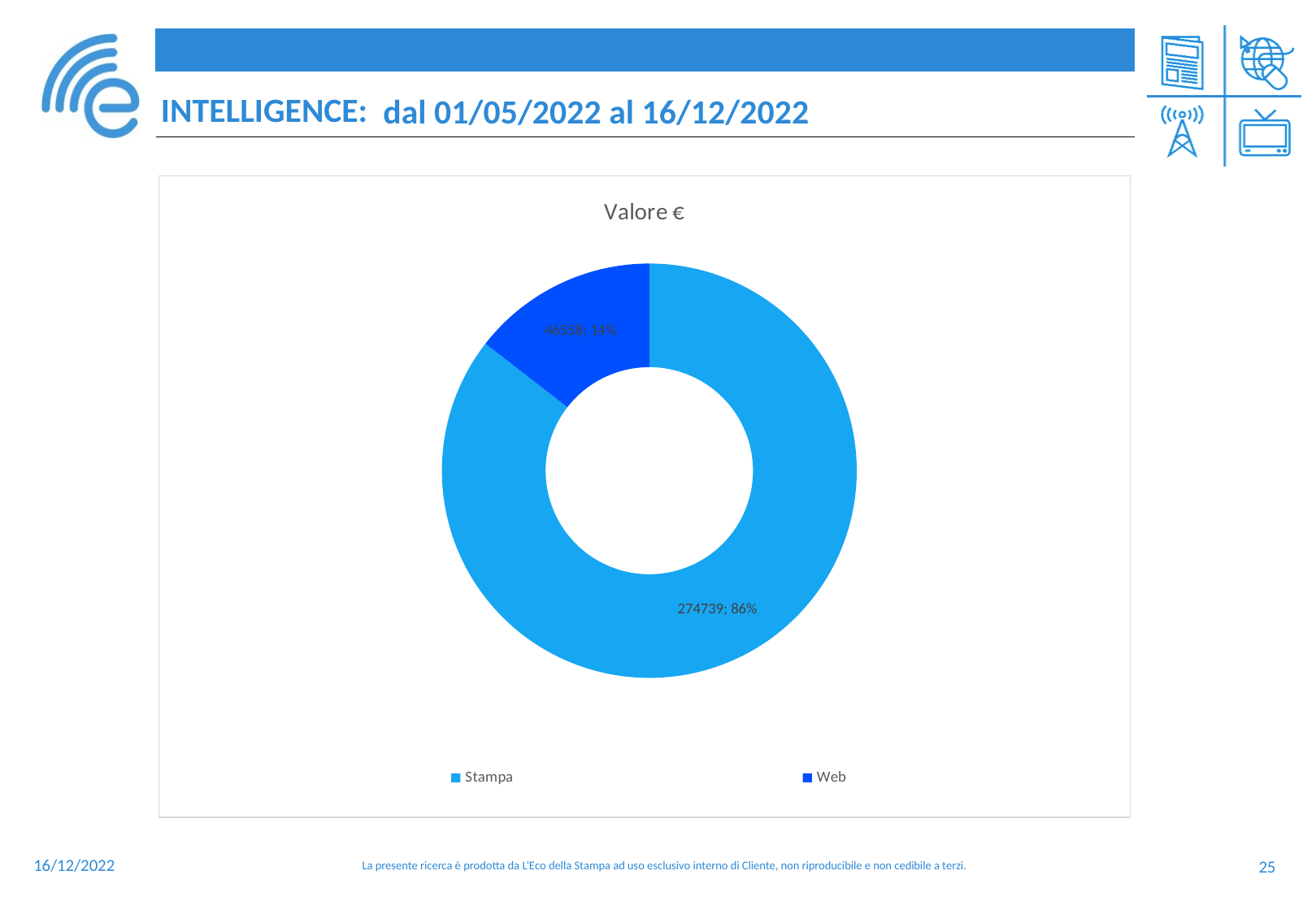
Which category has the lowest value in the Valore € chart? Web What is the total of the two values in the Valore € chart? 321297 What share of the Valore € chart does Stampa represent? 86% What is the value for Stampa in the Valore € chart? 274739 What share of the Valore € chart does Web represent? 14% Which is larger in the Valore € chart, Stampa or Web? Stampa What is the difference between the Stampa and Web values in the Valore € chart? 228181 What is the title of the chart on the slide? Valore € How many categories are shown in the Valore € chart? 2 What is the value for Web in the Valore € chart? 46558 What kind of chart is shown on the slide? doughnut chart Which category has the highest value in the Valore € chart? Stampa